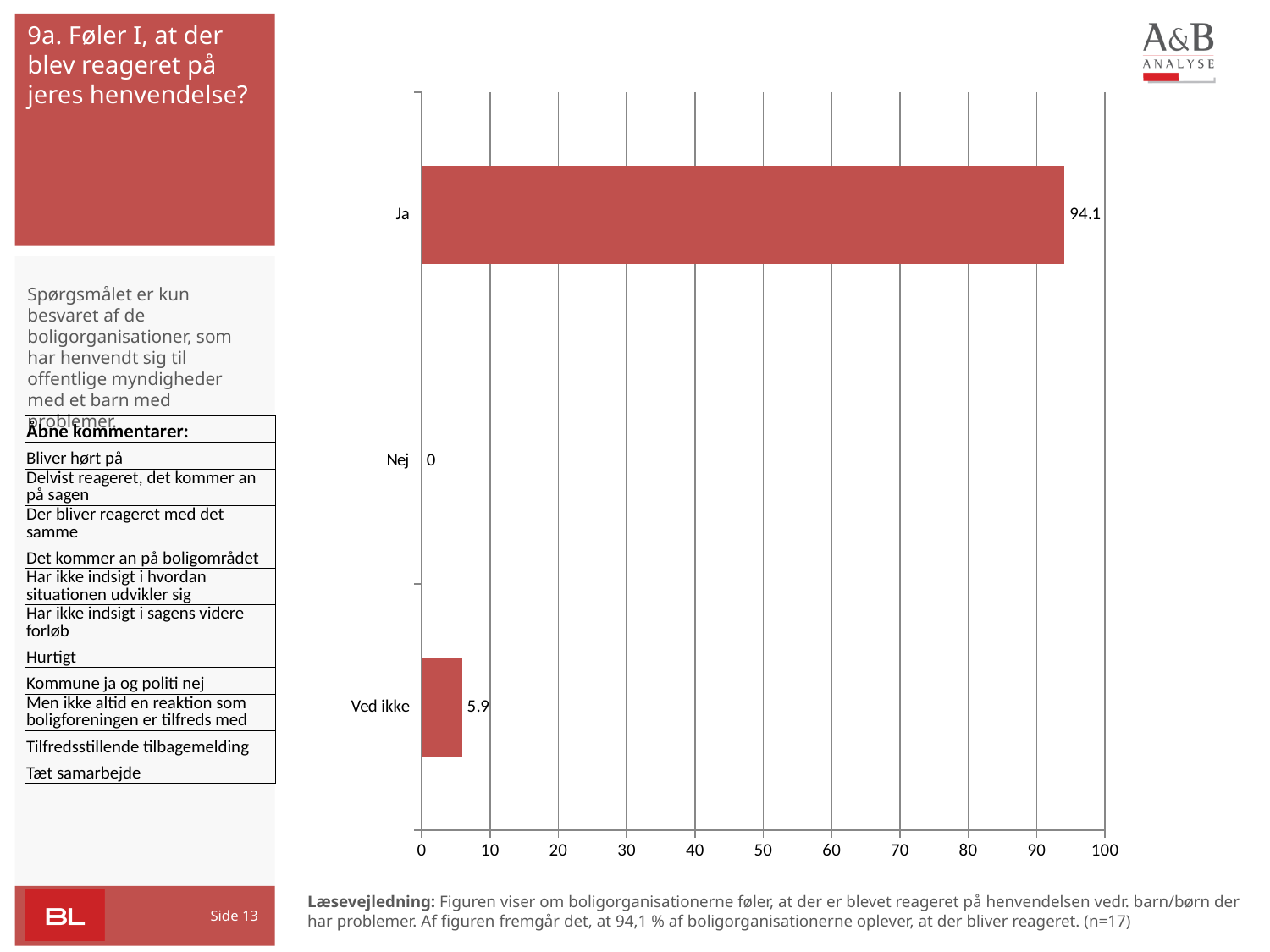
What is the value for "Ved ikke"? 5.9 Is the value for "Ved ikke" greater or less than 10? less What is the value for "Nej"? 0 What kind of chart is shown on the slide? bar chart Is the value for "Ja" greater or less than 90? greater What is the value for "Ja"? 94.1 What is the difference between the values for "Ja" and "Ved ikke"? 88.2 How many categories are shown in the chart? 3 Which is larger, the value for "Ved ikke" or the value for "Nej"? Ved ikke What is the maximum value shown on the horizontal axis? 100 Which category has the highest value? Ja Which category has the lowest value? Nej